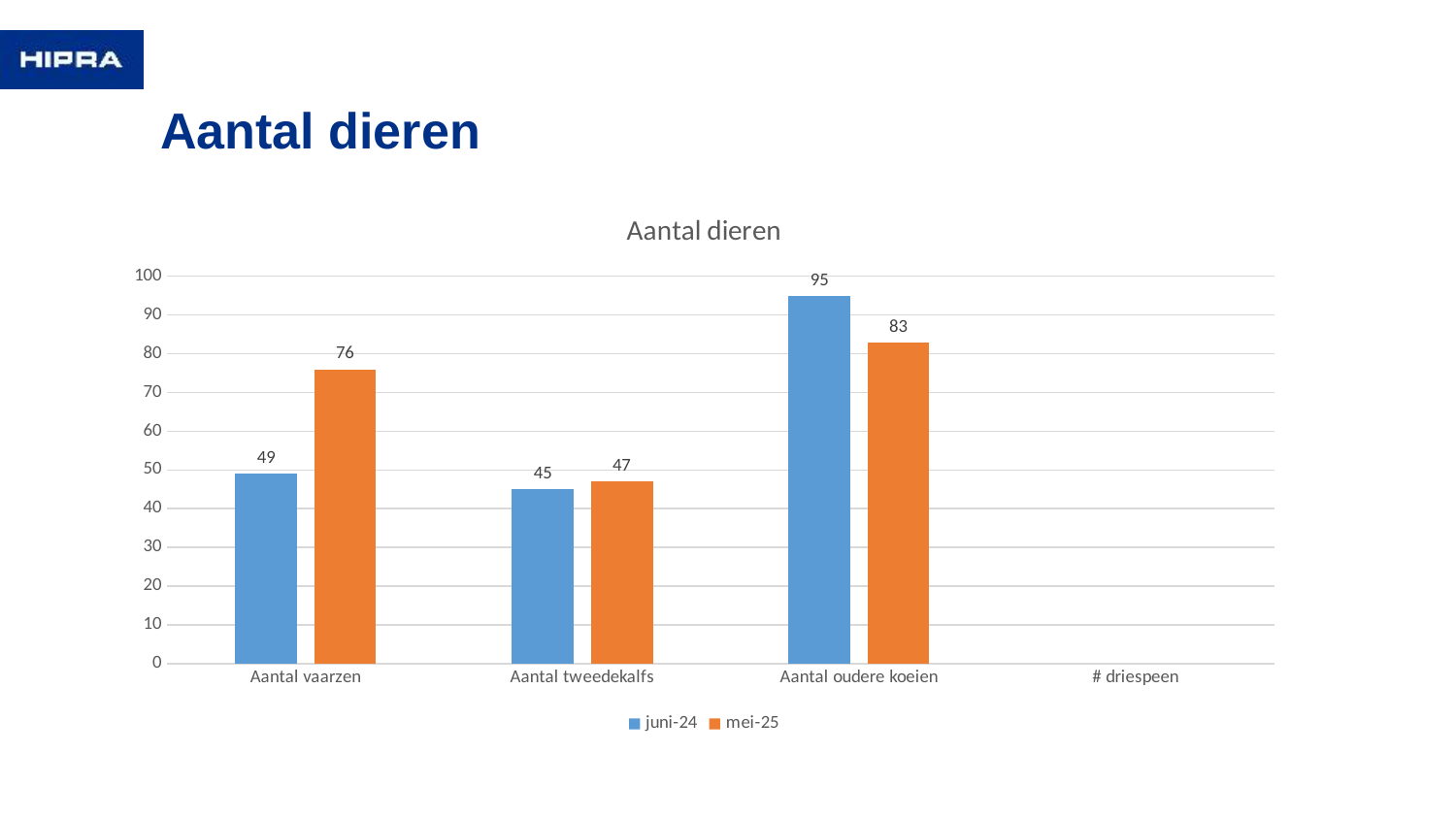
What is the difference between the juni-24 and mei-25 values for Aantal vaarzen? 27 What is the value for Aantal oudere koeien in the juni-24 series? 95 How many categories are shown on the x axis? 4 Which category has the highest value in the juni-24 series? Aantal oudere koeien How many series does the legend list? 2 What is the title of the chart? Aantal dieren What is the value for Aantal vaarzen in the mei-25 series? 76 What is the value for Aantal tweedekalfs in the juni-24 series? 45 What kind of chart is shown on the slide? Bar chart What is the difference between the juni-24 and mei-25 values for Aantal oudere koeien? 12 Which is larger for Aantal oudere koeien: the juni-24 value or the mei-25 value? juni-24 Which category has the lowest value in the mei-25 series? Aantal tweedekalfs